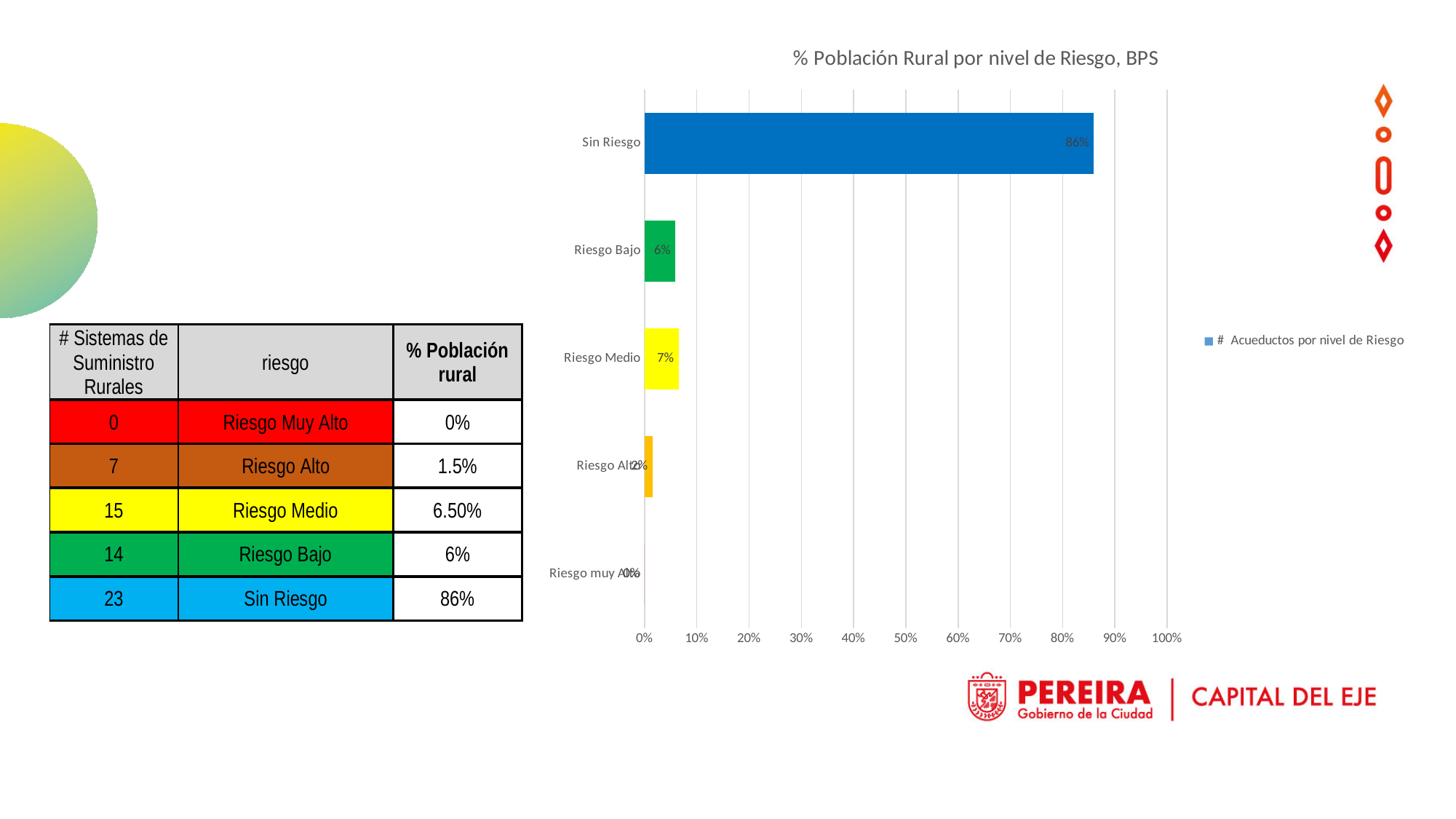
What is the value for Sin Riesgo in the chart? 86% Which category has the lowest value in the chart? Riesgo muy Alto What kind of chart is shown on the slide? bar chart What is the value for Riesgo Bajo in the chart? 6% What is the difference between the values for Sin Riesgo and Riesgo Bajo? 80% Which is larger, the value for Riesgo Medio or the value for Riesgo Bajo? Riesgo Medio Is the value for Sin Riesgo greater or less than 80%? greater How many categories are shown in the chart? 5 Which category has the highest value in the chart? Sin Riesgo What is the value for Riesgo Alto in the chart? 2% What is the title of the chart? % Población Rural por nivel de Riesgo, BPS What is the value for Riesgo Medio in the chart? 7%